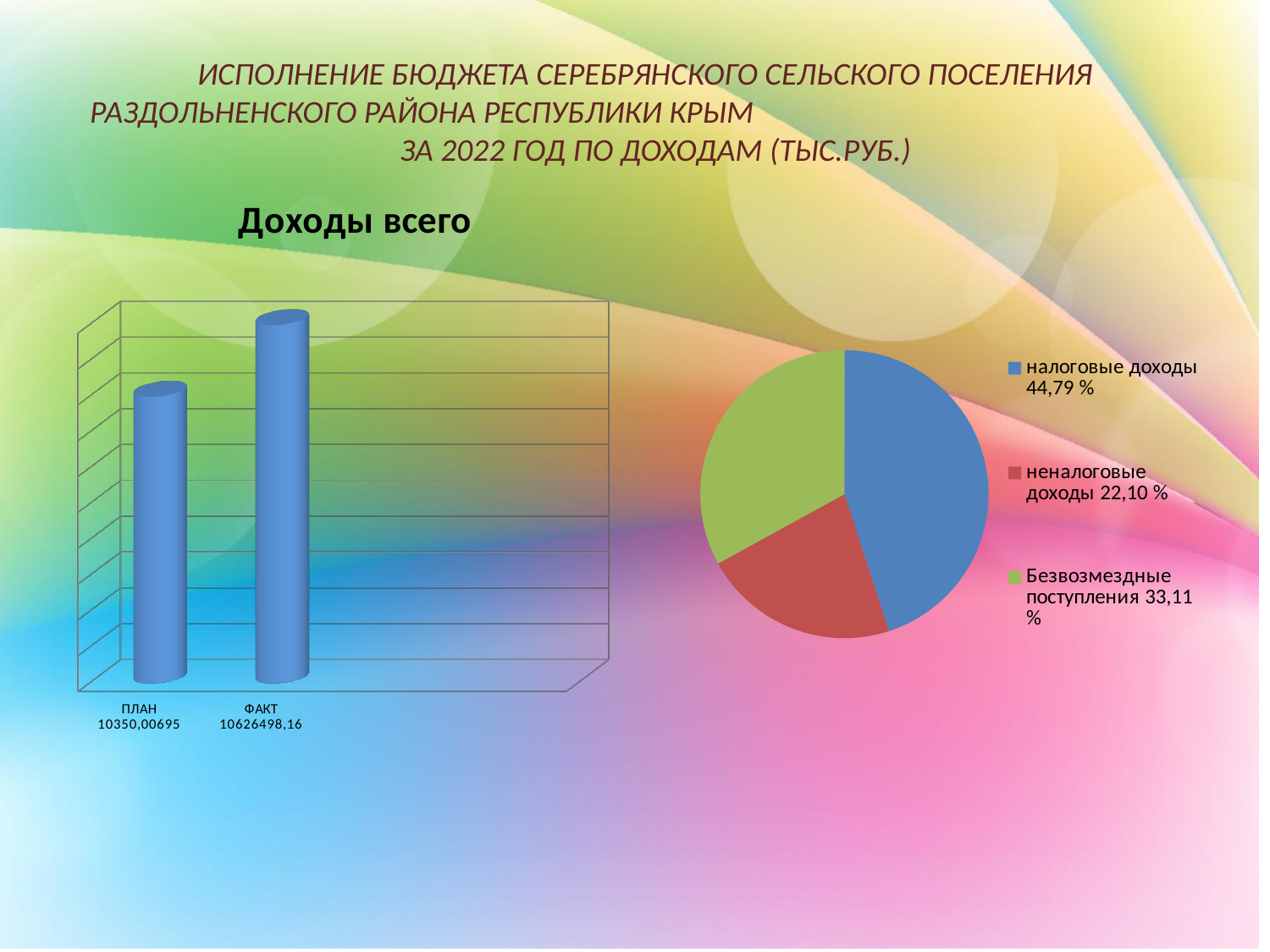
In the pie chart on the right, what share is shown for неналоговые доходы? 22,10 % What kind of chart is the chart titled "Доходы всего" on the left of the slide? bar chart In the pie chart on the right, what share is shown for Безвозмездные поступления? 33,11 % In the "Доходы всего" bar chart, how many categories are shown? 2 In the "Доходы всего" bar chart, what value is printed for ПЛАН? 10350,00695 In the pie chart on the right, what share is shown for налоговые доходы? 44,79 % In the pie chart on the right, which category has the largest slice? налоговые доходы In the "Доходы всего" bar chart, which bar is taller, ПЛАН or ФАКТ? ФАКТ What kind of chart is the chart on the right of the slide? pie chart In the "Доходы всего" bar chart, what value is printed for ФАКТ? 10626498,16 In the pie chart on the right, which category has the smallest slice? неналоговые доходы In the pie chart on the right, how many slices are there? 3